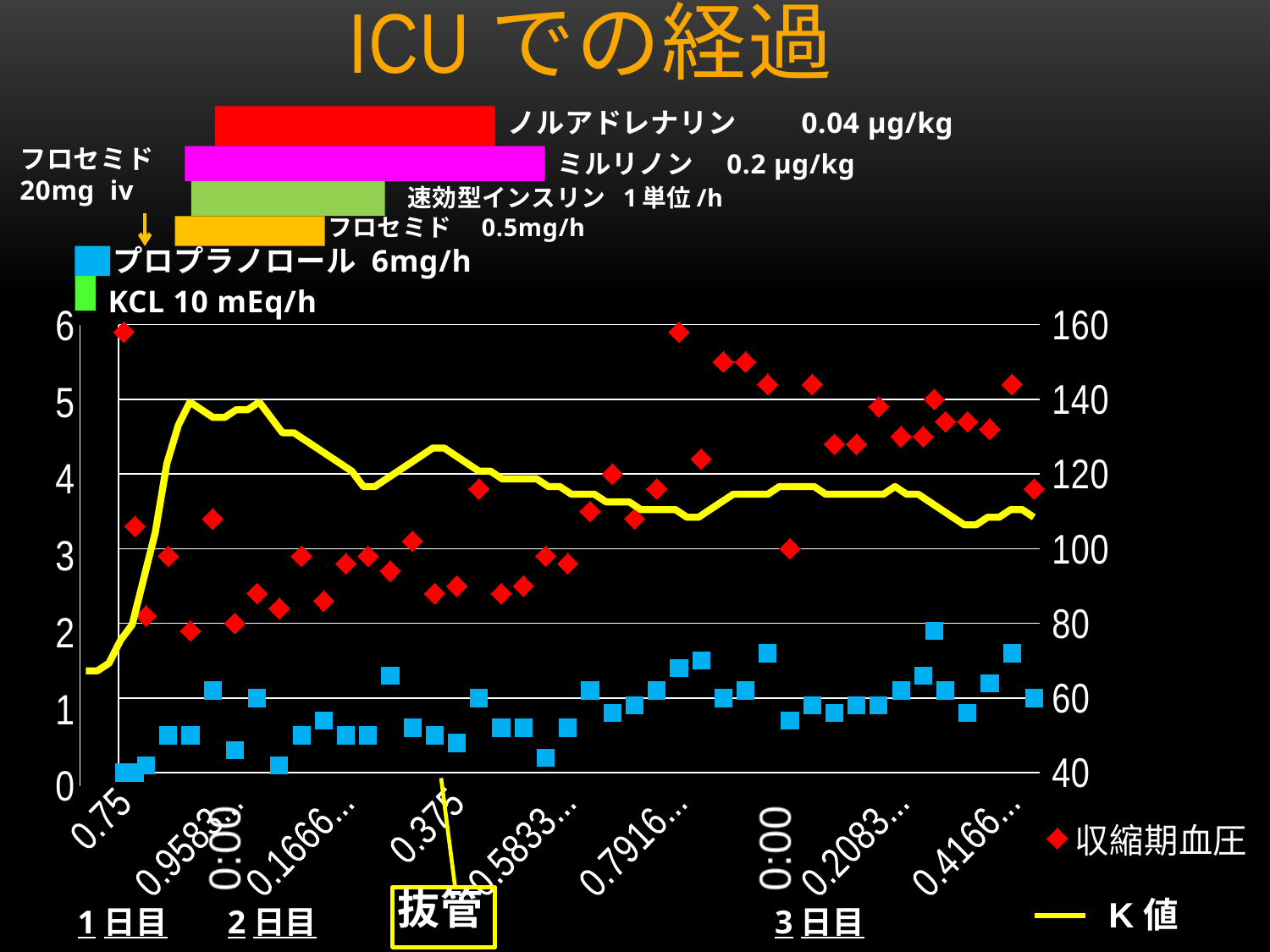
Which series is drawn as a yellow line? K 値 Is the peak value of the K 値 line greater or less than 4 on the left axis? greater Are all the blue square markers greater or less than 100 on the right axis? less After reaching its peak early on day 1, does the K 値 line generally rise or fall toward the end of the chart? fall Is the first 収縮期血圧 point (at 0.75) greater or less than 140 on the right axis? greater What is the highest value shown on the right-hand axis? 160 Which series has higher values throughout the chart, the red diamonds (収縮期血圧) or the blue squares? 収縮期血圧 (red diamonds) Which series is plotted with red diamond markers? 収縮期血圧 How many series does the chart legend list? 2 What is the highest value shown on the left-hand axis? 6 How many days (日目) are marked along the bottom of the chart? 3 What is the title of the chart on the slide? ICU での経過